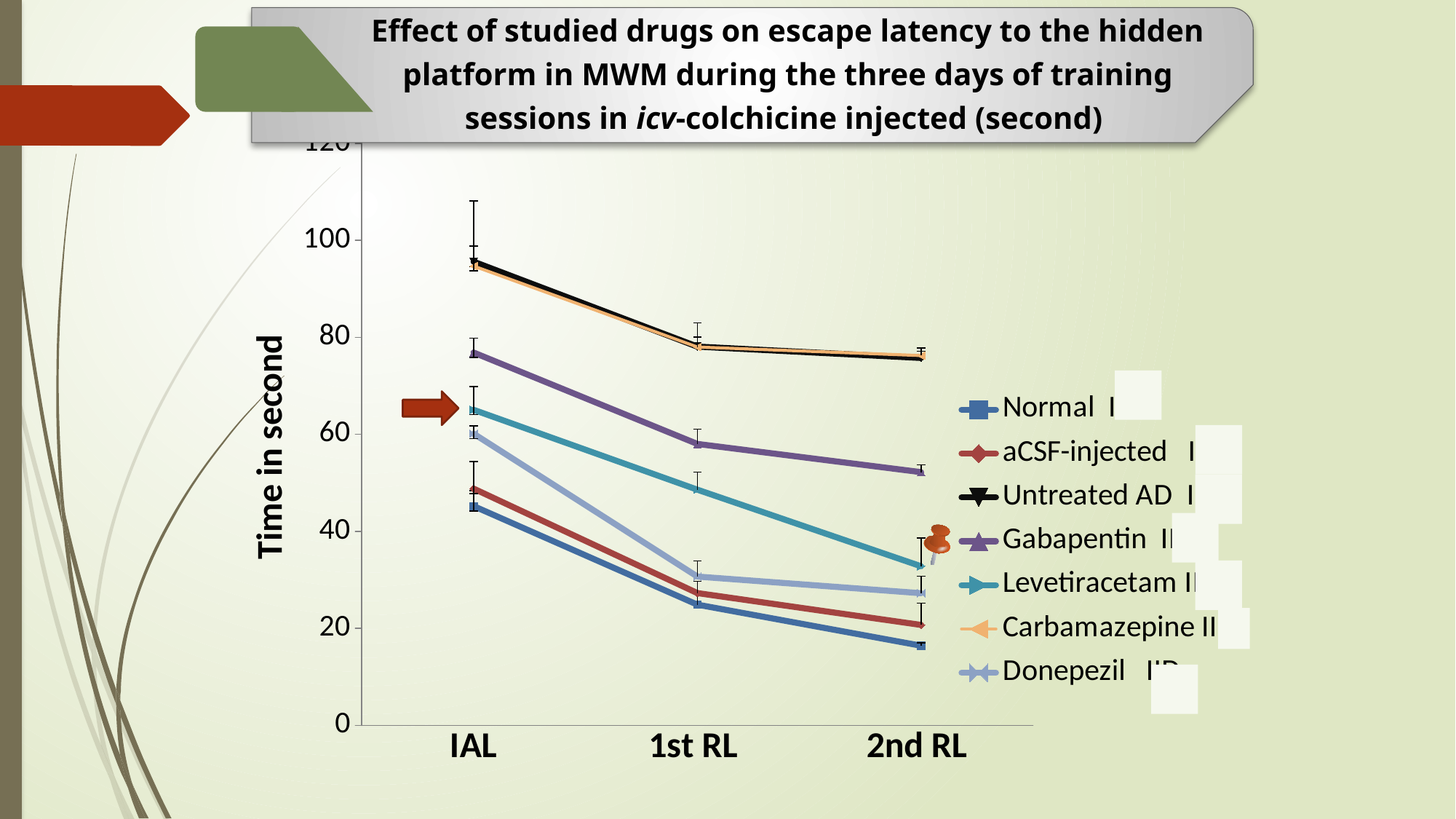
Which series is shown with a purple line and triangle markers? Gabapentin Which series has the lowest value at 2nd RL? Normal How many series does the legend list? 7 How many training session categories are shown on the x axis? 3 What is the label of the y axis? Time in second What kind of chart is shown on the slide? Line chart Does the escape latency for the Normal group rise or fall from IAL to 2nd RL? Fall Is the value for Gabapentin at IAL greater or less than 60? greater Is the value for Normal at 2nd RL greater or less than 20? less At 1st RL, which is larger: the value for Gabapentin or the value for Levetiracetam? Gabapentin Is the value for Untreated AD at 1st RL greater or less than 60? greater